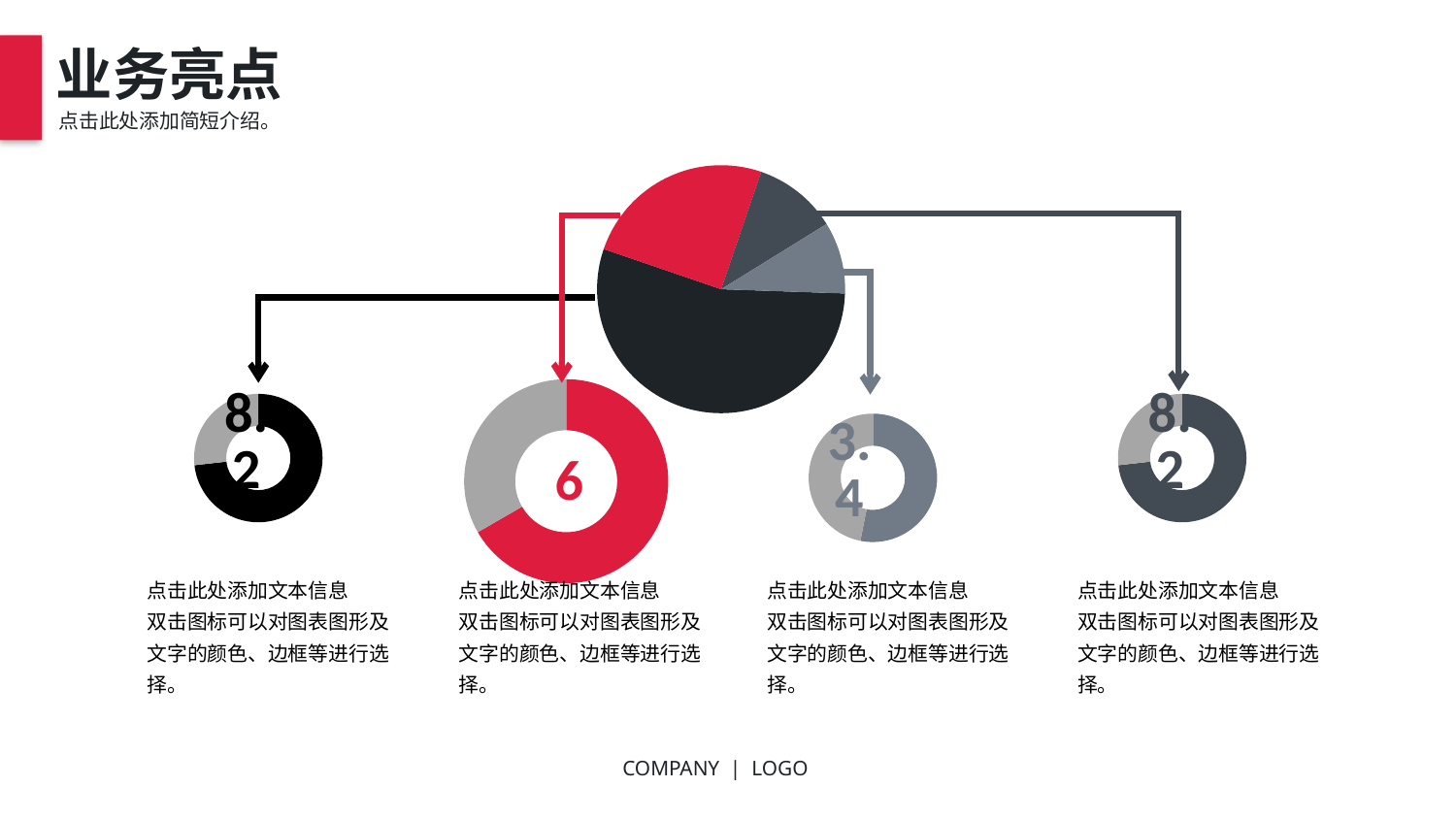
What is the difference between the number in the leftmost donut chart and the number in the third donut chart? 4.8 What number is shown in the centre of the rightmost donut chart? 8.2 How many slices does the central pie chart have? 4 What number is shown in the centre of the leftmost donut chart? 8.2 What colour is the filled portion of the second donut chart from the left? red What kind of chart is the large chart at the top centre of the slide? pie chart What number is shown in the centre of the third donut chart from the left? 3.4 Which donut chart shows the smallest number? the third from the left (3.4) How many small donut charts are shown below the central pie chart? 4 Which colour slice is the largest in the central pie chart? black Which shows a larger number, the second donut chart or the third donut chart? the second (6) What number is shown in the centre of the second donut chart from the left? 6